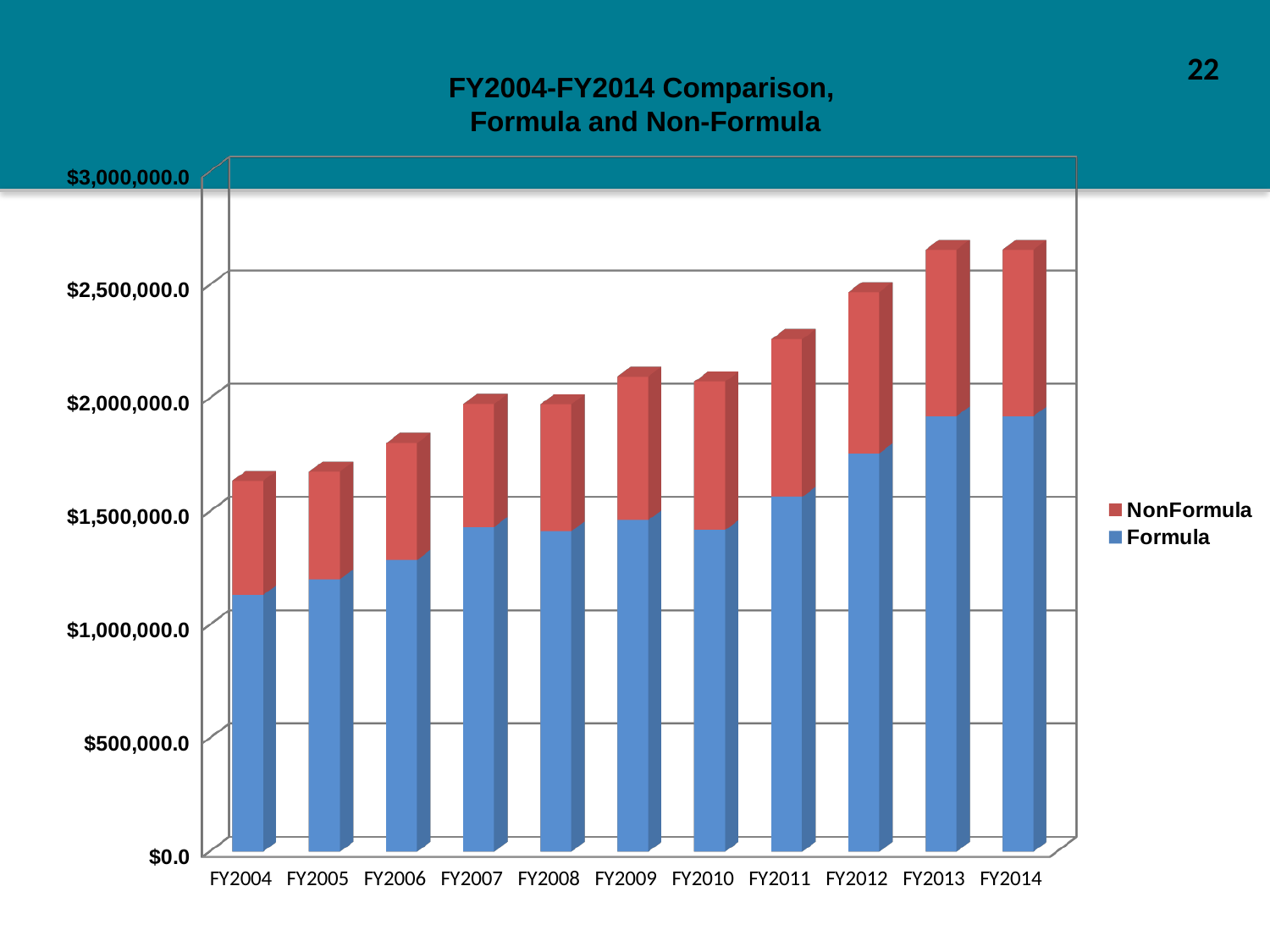
Which has the larger total bar, FY2011 or FY2012? FY2012 Which fiscal year has the lowest total bar? FY2004 Is the total bar for FY2004 greater or less than $1,500,000.0? greater How many fiscal years are shown on the x axis? 11 Is the Formula value for FY2014 greater or less than $2,000,000.0? less Do the total bar heights generally rise or fall from FY2004 to FY2014? Rise Is the total bar for FY2006 greater or less than $2,000,000.0? less What kind of chart is shown on the slide? Stacked bar chart What are the two series named in the legend? NonFormula and Formula Which series is shown in blue? Formula How many series does the legend list? 2